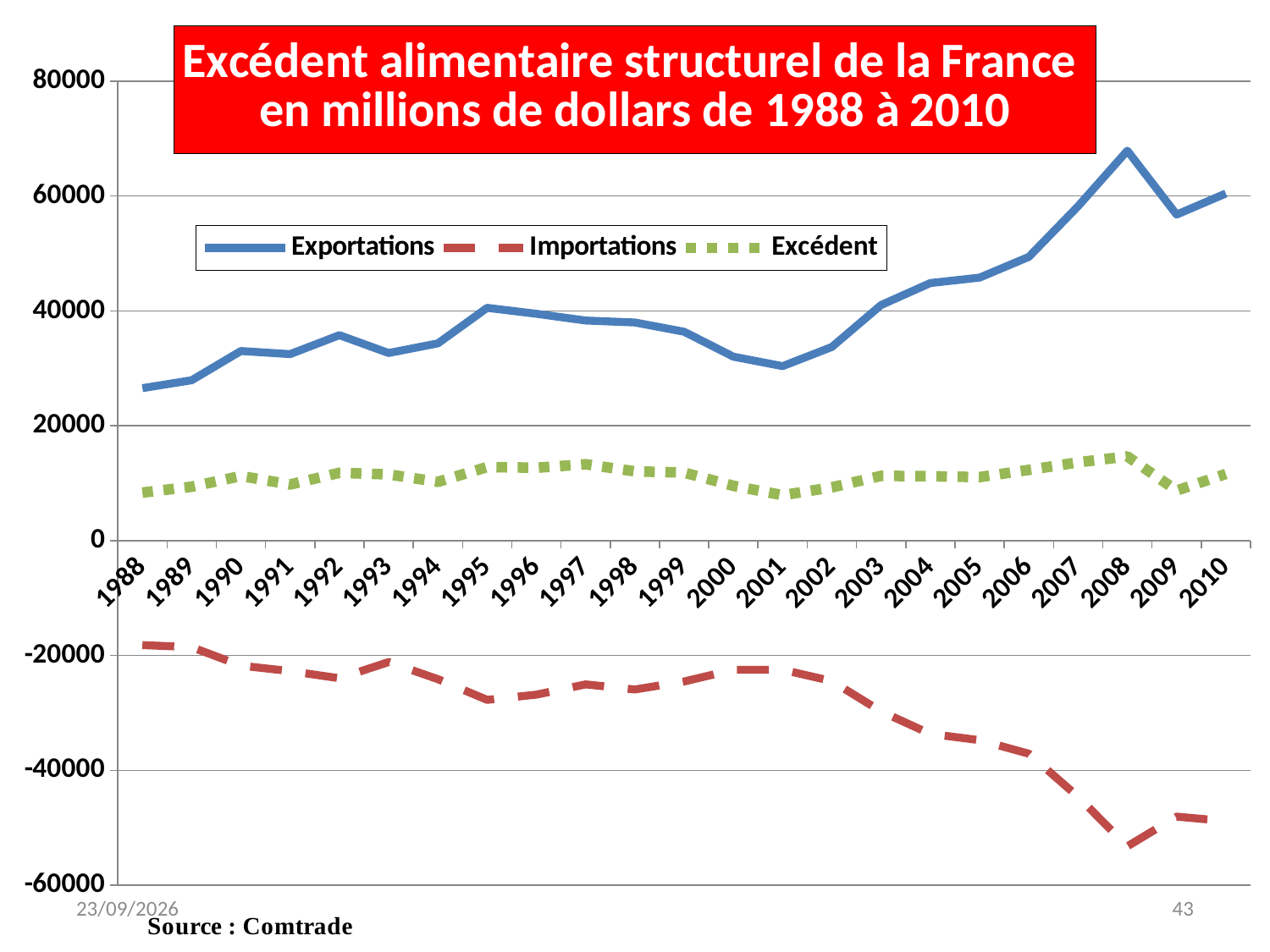
How many series does the legend list? 3 How many years are plotted along the x axis? 23 Is the value of Exportations in 1988 greater or less than 40000? less Is the value of Exportations in 2008 greater or less than 60000? greater Is the value of Importations in 2008 greater or less than -40000? less Which is larger, Exportations in 2008 or Exportations in 2009? 2008 In which year do Exportations reach their highest value? 2008 In which year are Exportations at their lowest? 1988 What kind of chart is shown on the slide? line chart In which year do Importations reach their lowest (most negative) value? 2008 Do Importations rise or fall between 2001 and 2008? fall What is the source cited below the chart? Comtrade